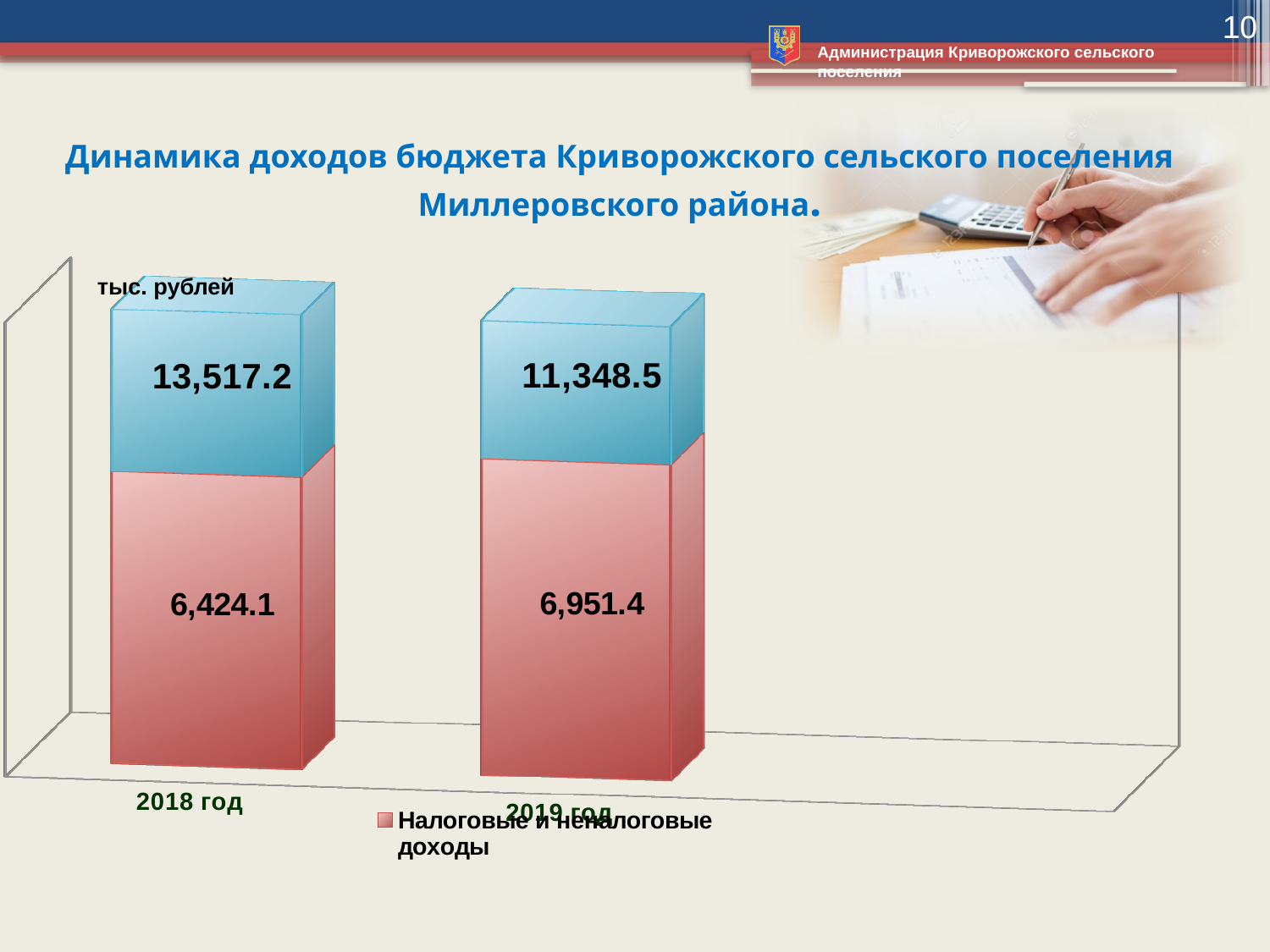
What is the difference between the blue segment values for 2018 год and 2019 год? 2,168.7 What is the value of Налоговые и неналоговые доходы for 2018 год? 6,424.1 What unit of measurement is indicated on the chart? тыс. рублей What is the value of Налоговые и неналоговые доходы for 2019 год? 6,951.4 By how much did Налоговые и неналоговые доходы increase from 2018 год to 2019 год? 527.3 What value is printed on the blue (upper) segment of the 2019 год bar? 11,348.5 What is the total of the stacked bar for 2019 год? 18,299.9 What is the total of the stacked bar for 2018 год? 19,941.3 What value is printed on the blue (upper) segment of the 2018 год bar? 13,517.2 Which year has the larger blue (upper) segment, 2018 год or 2019 год? 2018 год How many years (categories) are shown on the chart? 2 Which year has the higher value for Налоговые и неналоговые доходы? 2019 год